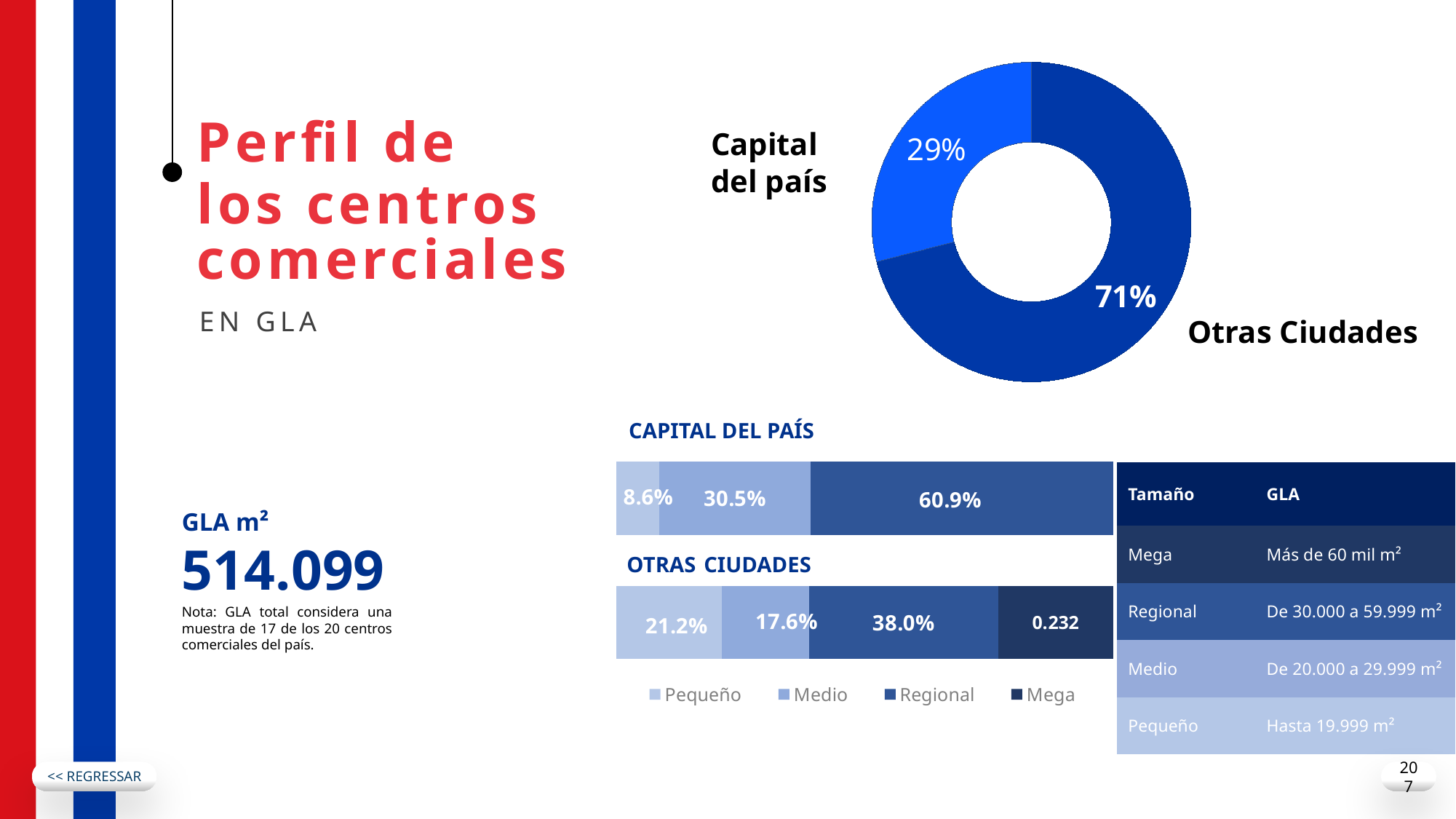
In the Capital del País stacked bar, what is the value of the Pequeño segment? 8.6% In the Otras Ciudades stacked bar, which segment is the largest? Regional What kind of chart is the one at the top right showing Capital del país and Otras Ciudades? Donut (pie) chart How many series does the legend below the stacked bars list? 4 In the Capital del País stacked bar, what is the difference between the Regional and Medio segments? 30.4% In the Otras Ciudades stacked bar, which is larger, the Pequeño segment or the Medio segment? Pequeño In the donut chart, which category has the larger share, Capital del país or Otras Ciudades? Otras Ciudades In the Capital del País stacked bar, what is the value of the Regional segment? 60.9% In the donut chart, what share is labelled for Capital del país? 29% What kind of chart is used for the Capital del País and Otras Ciudades breakdowns by size? Stacked bar chart In the donut chart, what share is labelled for Otras Ciudades? 71% In the Otras Ciudades stacked bar, what is the value of the Medio segment? 17.6%